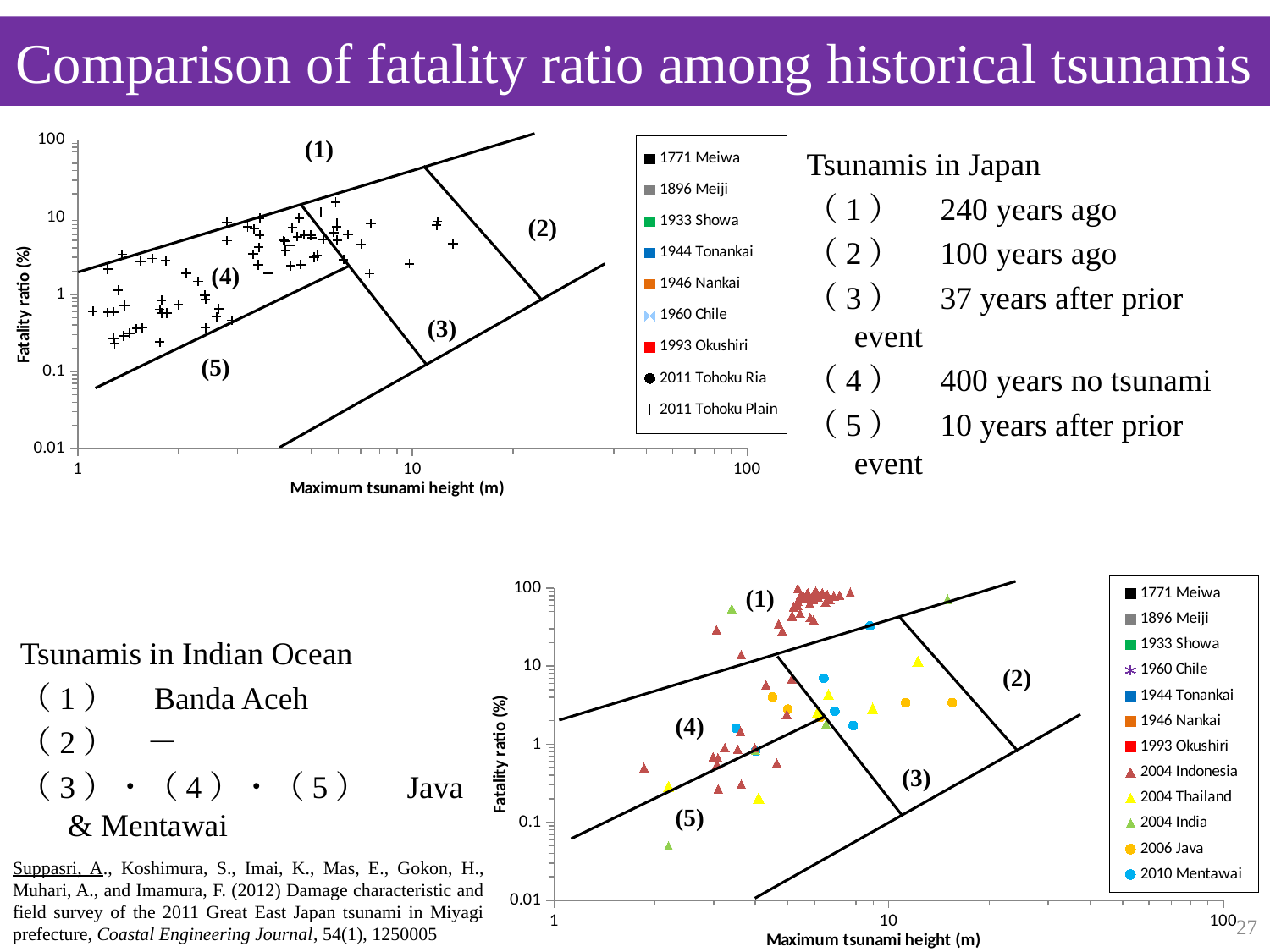
In the bottom chart, are the 2006 Java points greater or less than 10% fatality ratio? less In the top chart, which series has the most plotted points? 2011 Tohoku Plain In the bottom chart, which series has the most plotted points? 2004 Indonesia In the bottom chart, is the highest 2004 Indonesia point greater or less than 10% fatality ratio? greater How many series does the legend of the top chart list? 9 How many numbered zones, (1) to (5), are marked on the top chart? 5 In the top chart, does the fatality ratio generally rise or fall as maximum tsunami height increases along the x axis? rise What kind of chart is the top chart on the slide? scatter chart What is the x-axis label of the bottom chart? Maximum tsunami height (m) What kind of chart is the bottom chart on the slide? scatter chart How many series does the legend of the bottom chart list? 12